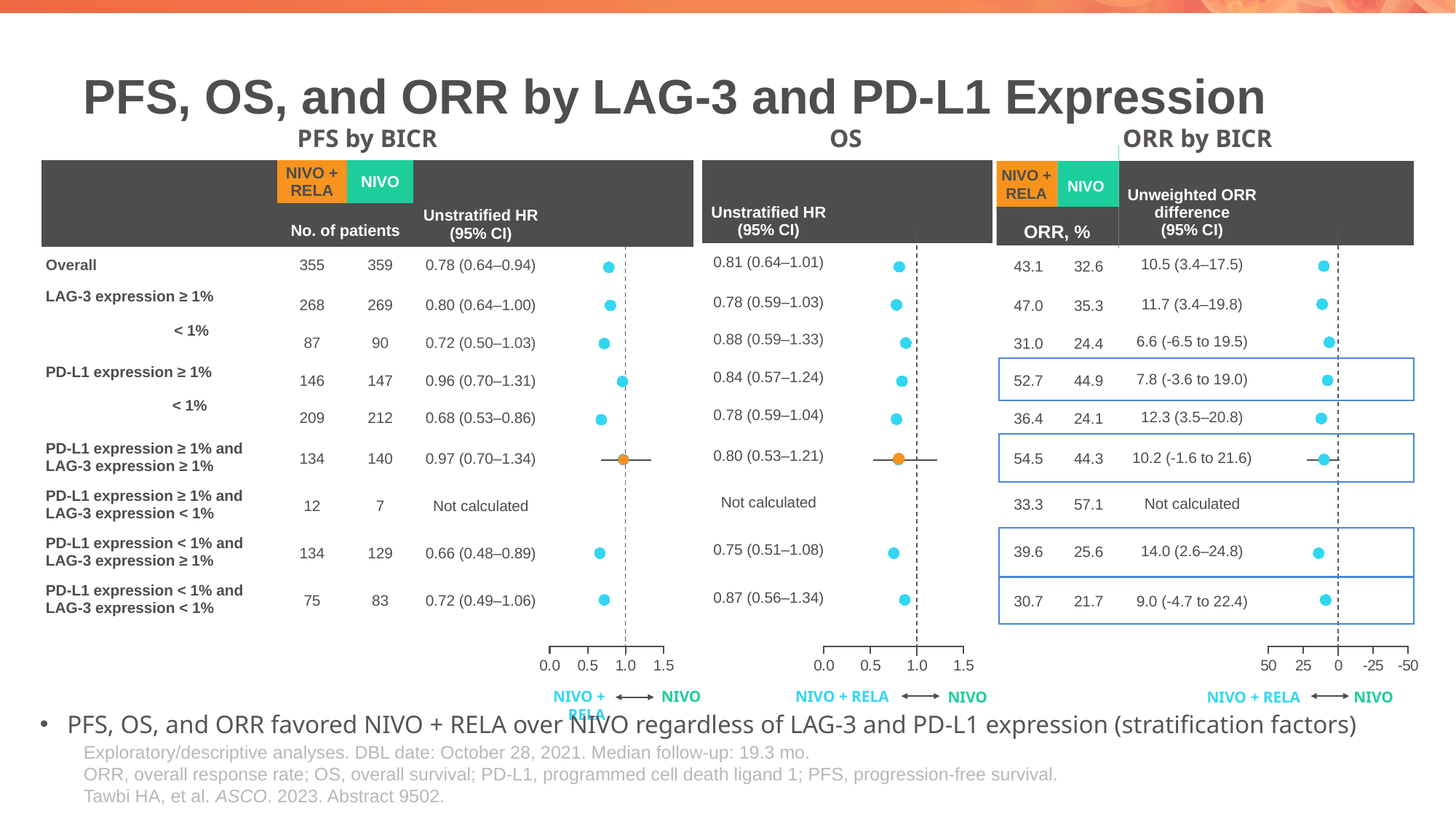
In the OS chart, what is the unstratified HR (95% CI) for LAG-3 expression ≥ 1%? 0.78 (0.59–1.03) In the ORR by BICR chart, which subgroup has the highest unweighted ORR difference? PD-L1 expression < 1% and LAG-3 expression ≥ 1% In the OS chart, is the unstratified HR for the Overall group greater or less than 1.0? less In the PFS by BICR chart, which has the larger unstratified HR: PD-L1 expression ≥ 1% or PD-L1 expression < 1%? PD-L1 expression ≥ 1% In the PFS by BICR chart, what is the difference in number of patients between NIVO and NIVO + RELA in the Overall group? 4 What kind of chart is used to display the hazard ratios in the PFS by BICR and OS panels? Forest plot In the ORR by BICR chart, what is the unweighted ORR difference (95% CI) for PD-L1 expression < 1% and LAG-3 expression ≥ 1%? 14.0 (2.6–24.8) In the ORR by BICR chart, what is the ORR, % for NIVO + RELA in the Overall group? 43.1 In the ORR by BICR chart, what is the difference in ORR, % between NIVO + RELA and NIVO for the Overall group? 10.5 In the PFS by BICR chart, what is the unstratified HR (95% CI) for the Overall group? 0.78 (0.64–0.94) In the PFS by BICR chart, which subgroup has the lowest unstratified HR? PD-L1 expression < 1% and LAG-3 expression ≥ 1% In the PFS by BICR chart, how many subgroup rows have a plotted point (excluding the 'Not calculated' row)? 8